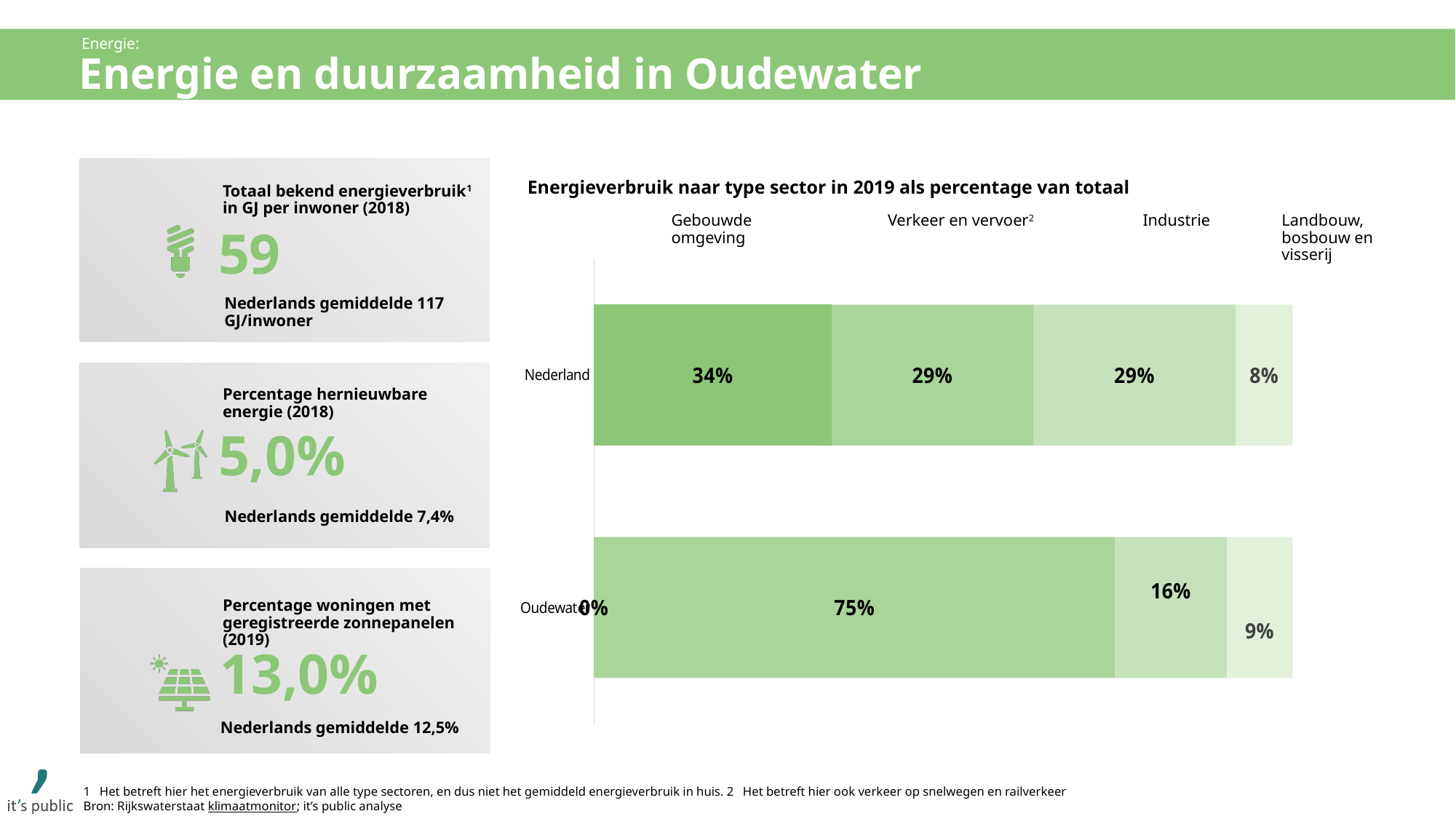
In the chart 'Energieverbruik naar type sector in 2019 als percentage van totaal', what is the difference between the Verkeer en vervoer share for Oudewater and for Nederland? 46% In the chart 'Energieverbruik naar type sector in 2019 als percentage van totaal', which sector has the largest share for Oudewater? Verkeer en vervoer In the chart 'Energieverbruik naar type sector in 2019 als percentage van totaal', what is the value for Gebouwde omgeving for Oudewater? 0% In the chart 'Energieverbruik naar type sector in 2019 als percentage van totaal', which sector has the smallest share for Nederland? Landbouw, bosbouw en visserij In the chart 'Energieverbruik naar type sector in 2019 als percentage van totaal', what is the value for Industrie for Oudewater? 16% In the chart 'Energieverbruik naar type sector in 2019 als percentage van totaal', what is the value for Verkeer en vervoer for Oudewater? 75% What type of chart is 'Energieverbruik naar type sector in 2019 als percentage van totaal'? Stacked bar chart In the chart 'Energieverbruik naar type sector in 2019 als percentage van totaal', which is larger: the Industrie share for Nederland or for Oudewater? Nederland How many bars (regions) are shown in the chart 'Energieverbruik naar type sector in 2019 als percentage van totaal'? 2 In the chart 'Energieverbruik naar type sector in 2019 als percentage van totaal', what is the value for Gebouwde omgeving for Nederland? 34% In the chart 'Energieverbruik naar type sector in 2019 als percentage van totaal', what is the value for Landbouw, bosbouw en visserij for Nederland? 8% How many sectors (series) are shown in the chart 'Energieverbruik naar type sector in 2019 als percentage van totaal'? 4